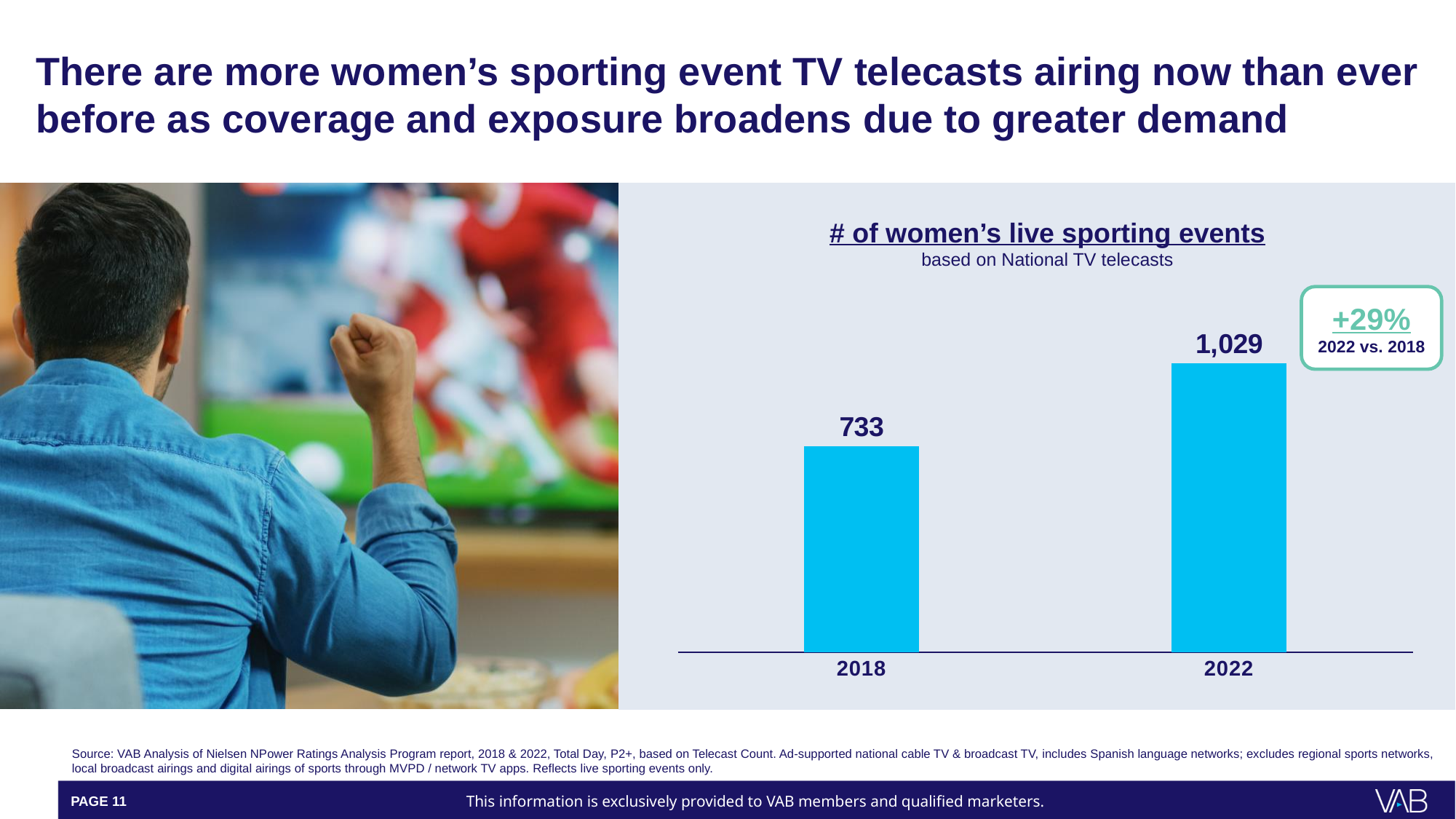
What percentage change is shown in the callout box for 2022 vs. 2018? +29% Which year has the higher number of women's live sporting events? 2022 Is the value for 2022 larger or smaller than the value for 2018? larger How many years are shown on the chart? 2 Which year has the lower number of women's live sporting events? 2018 What is the number of women's live sporting events for 2018? 733 Do the values rise or fall from 2018 to 2022? rise What is the title of the chart? # of women's live sporting events What is the difference between the 2022 and 2018 values? 296 What kind of chart is shown on the slide? bar chart What is the number of women's live sporting events for 2022? 1,029